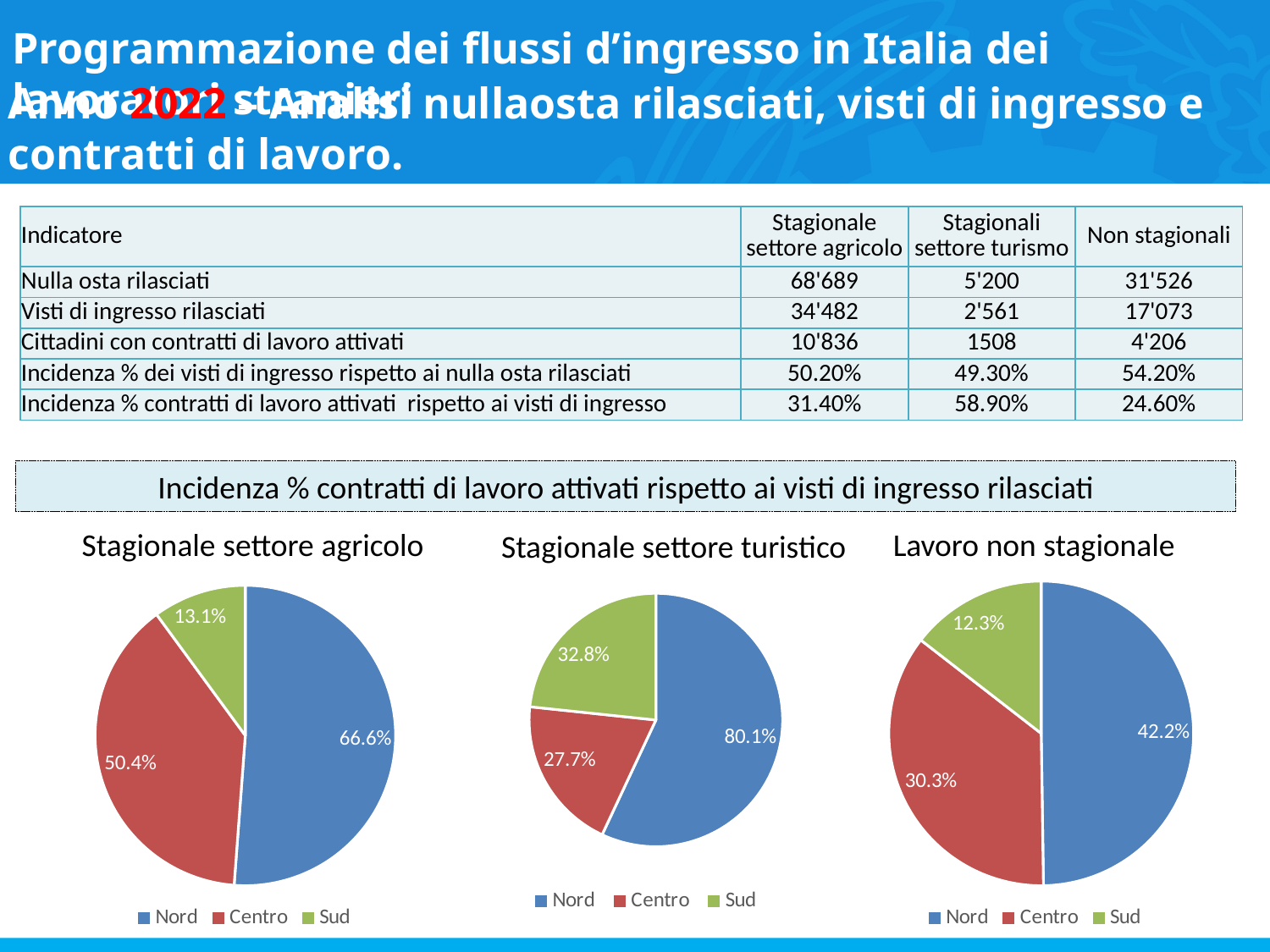
What type of chart is used for 'Lavoro non stagionale'? Pie chart In the 'Stagionale settore agricolo' pie chart, what is the difference between the values for Nord and Sud? 53.5 percentage points In the 'Stagionale settore turistico' pie chart, what is the value labelled for Nord? 80.1% In the 'Stagionale settore turistico' pie chart, what is the value labelled for Centro? 27.7% In the 'Lavoro non stagionale' pie chart, which is larger, the value for Centro or the value for Sud? Centro In the 'Stagionale settore agricolo' pie chart, which region has the smallest slice? Sud How many slices does the 'Stagionale settore turistico' pie chart have? 3 In the 'Stagionale settore agricolo' pie chart, what is the value labelled for Nord? 66.6% In the 'Stagionale settore turistico' pie chart, which region has the smallest labelled value? Centro In the 'Lavoro non stagionale' pie chart, what is the value labelled for Sud? 12.3% In the 'Lavoro non stagionale' pie chart, which region has the largest slice? Nord What are the legend entries of the 'Stagionale settore agricolo' pie chart? Nord, Centro, Sud